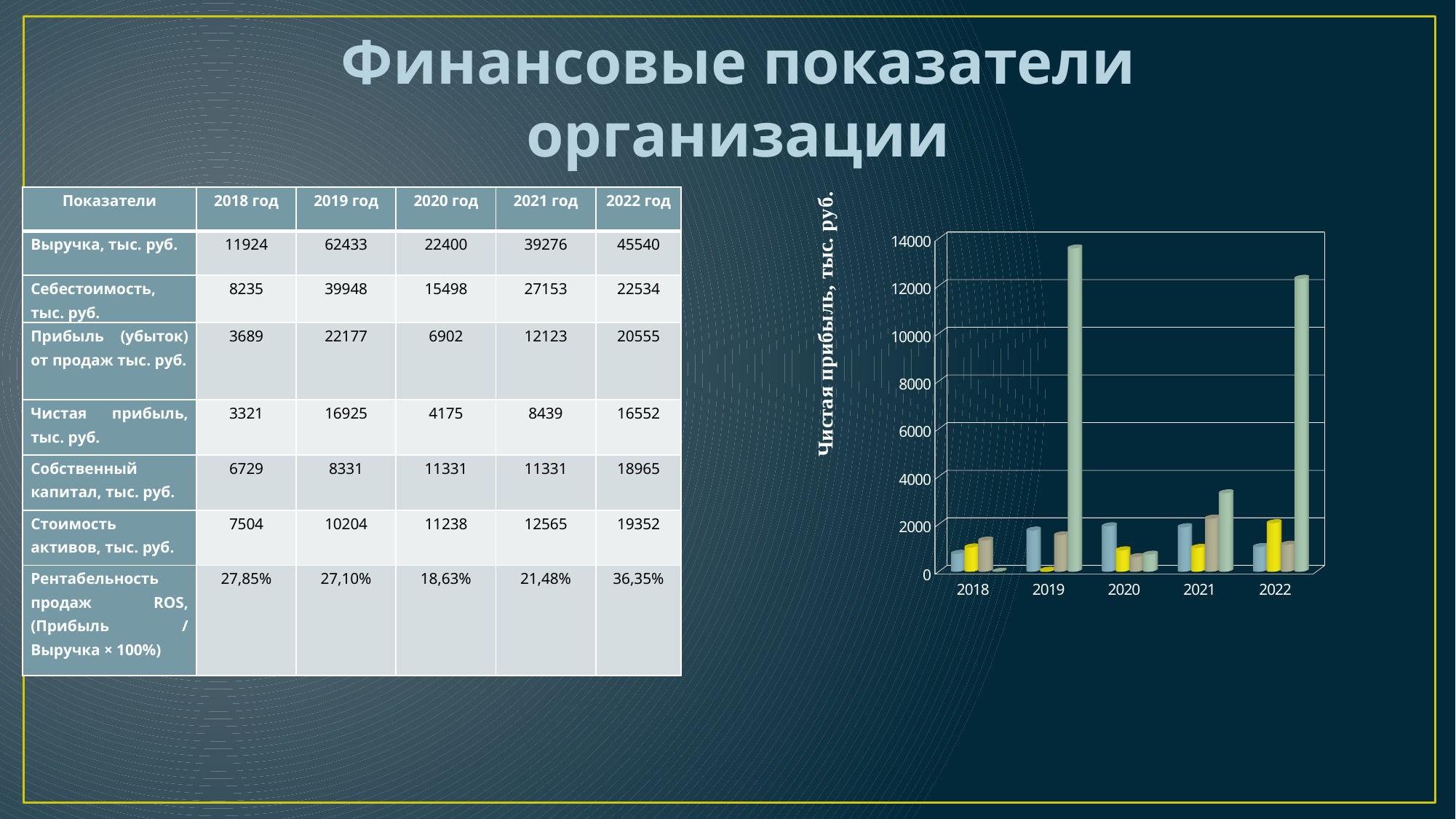
How many bars are plotted for each year in the chart? 4 In which year is the yellow bar the lowest? 2019 Is the tallest (green) bar for 2019 greater or less than 12000? greater Is the green bar for 2021 greater or less than 4000? less How many years are shown on the x axis of the chart? 5 What is the label of the vertical axis of the chart? Чистая прибыль, тыс. руб. What kind of chart is shown on the right of the slide? bar chart Is the blue bar for 2018 greater or less than 2000? less Which is larger in the chart: the green bar for 2019 or the green bar for 2022? the green bar for 2019 In which year does the chart show the tallest bar? 2019 Which is larger in the chart: the blue bar for 2018 or the blue bar for 2019? the blue bar for 2019